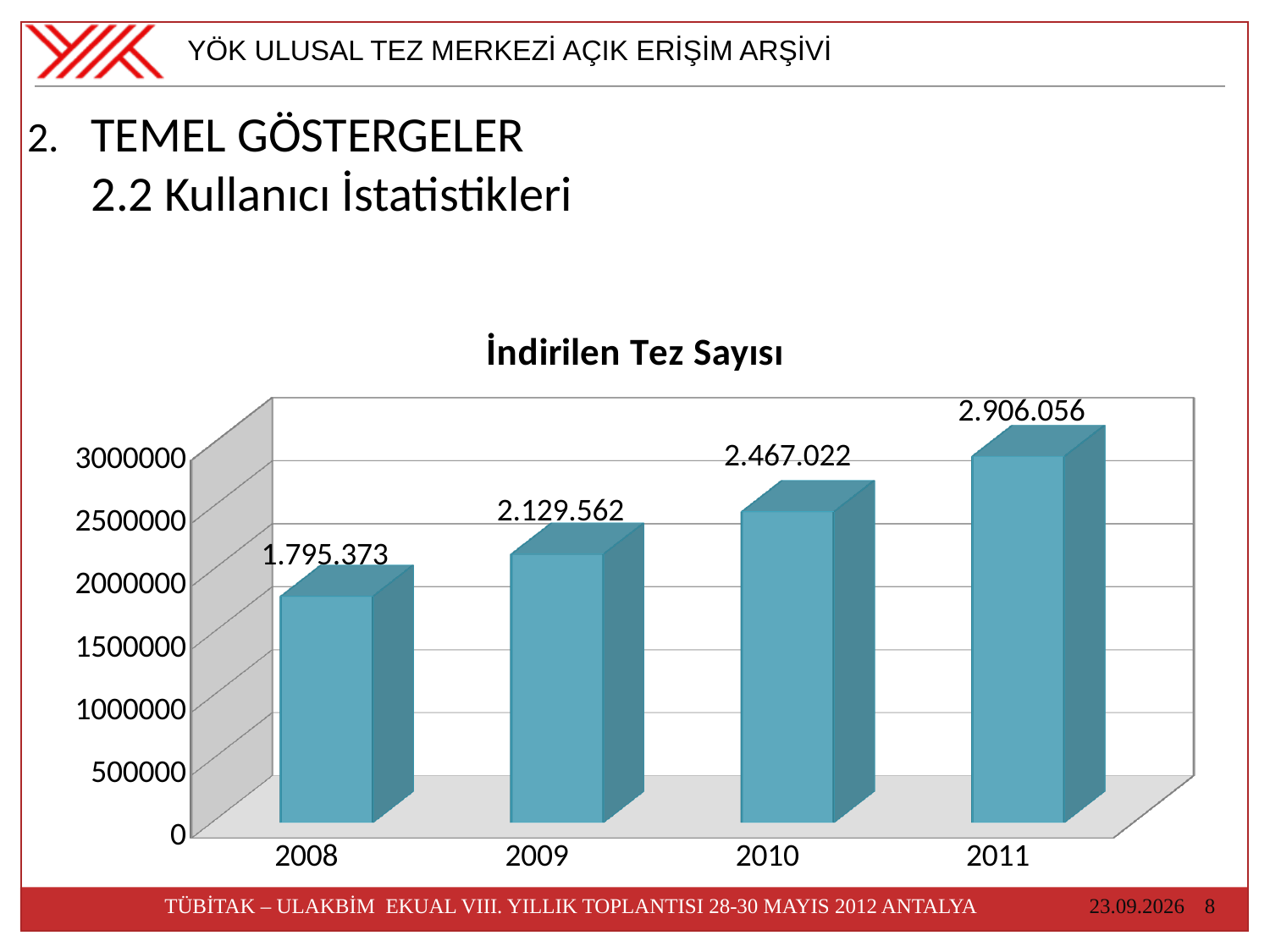
Which year has the lowest value in the İndirilen Tez Sayısı chart? 2008 What is the value for 2010 in the İndirilen Tez Sayısı chart? 2.467.022 How many years are shown on the x axis of the İndirilen Tez Sayısı chart? 4 Which is larger in the İndirilen Tez Sayısı chart, the value for 2009 or the value for 2010? 2010 What is the difference between the values for 2009 and 2008 in the İndirilen Tez Sayısı chart? 334.189 Which year has the highest value in the İndirilen Tez Sayısı chart? 2011 What is the value for 2011 in the İndirilen Tez Sayısı chart? 2.906.056 Is the value for 2008 in the İndirilen Tez Sayısı chart greater or less than 2000000? less What is the value for 2008 in the İndirilen Tez Sayısı chart? 1.795.373 Do the values in the İndirilen Tez Sayısı chart rise or fall from 2008 to 2011? rise What kind of chart is the İndirilen Tez Sayısı chart? bar chart What is the difference between the values for 2011 and 2010 in the İndirilen Tez Sayısı chart? 439.034